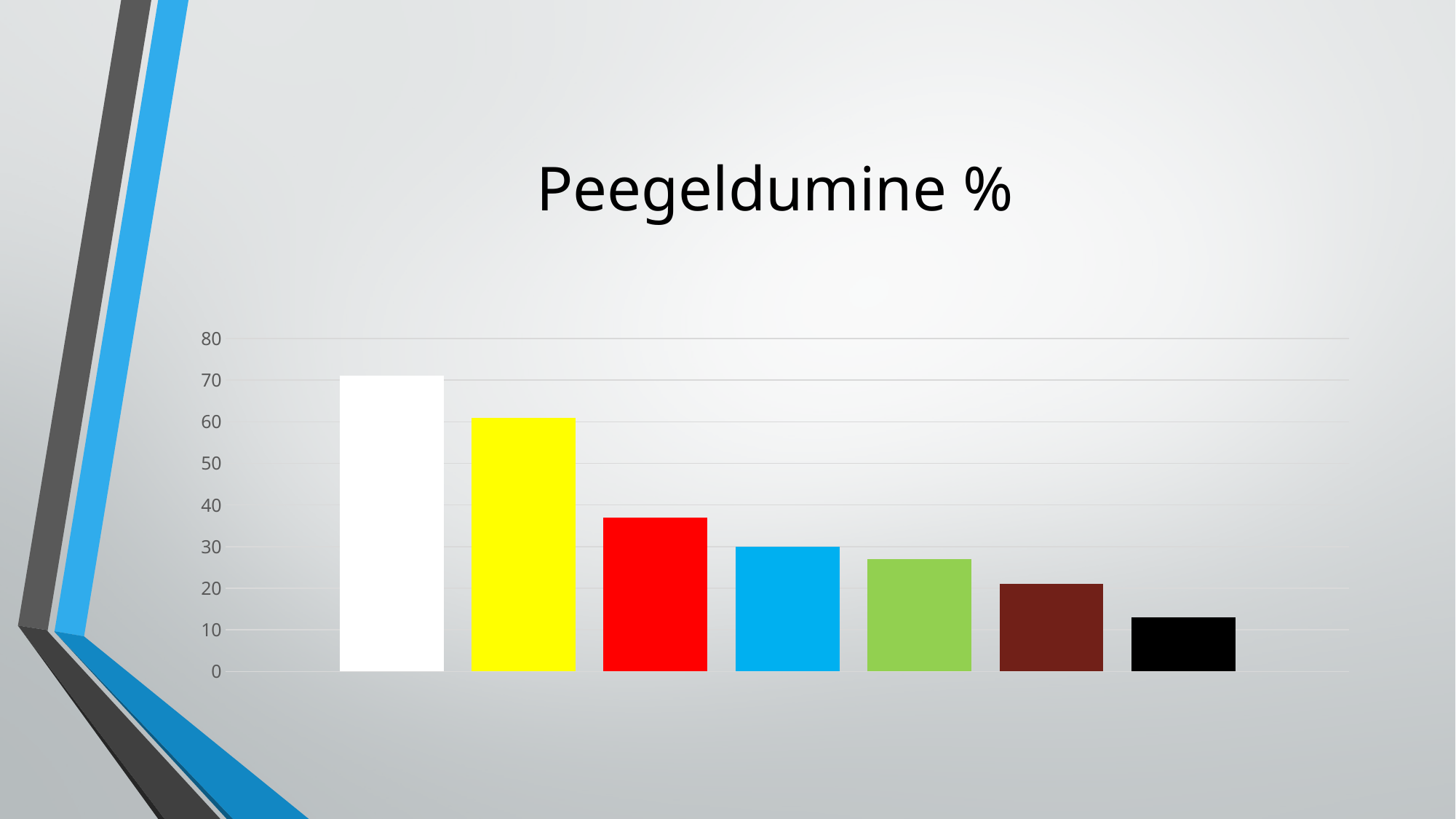
How many bars does the chart show? 7 What is the title of the chart? Peegeldumine % Which bar is the highest in the chart? the white bar Is the value of the red bar greater or less than 40? less Is the value of the green bar greater or less than 30? less Which bar is the lowest in the chart? the black bar Is the value of the black bar greater or less than 20? less What kind of chart is shown on the slide? bar chart Which is larger, the yellow bar or the red bar? the yellow bar Do the bar values rise or fall from left to right across the chart? fall